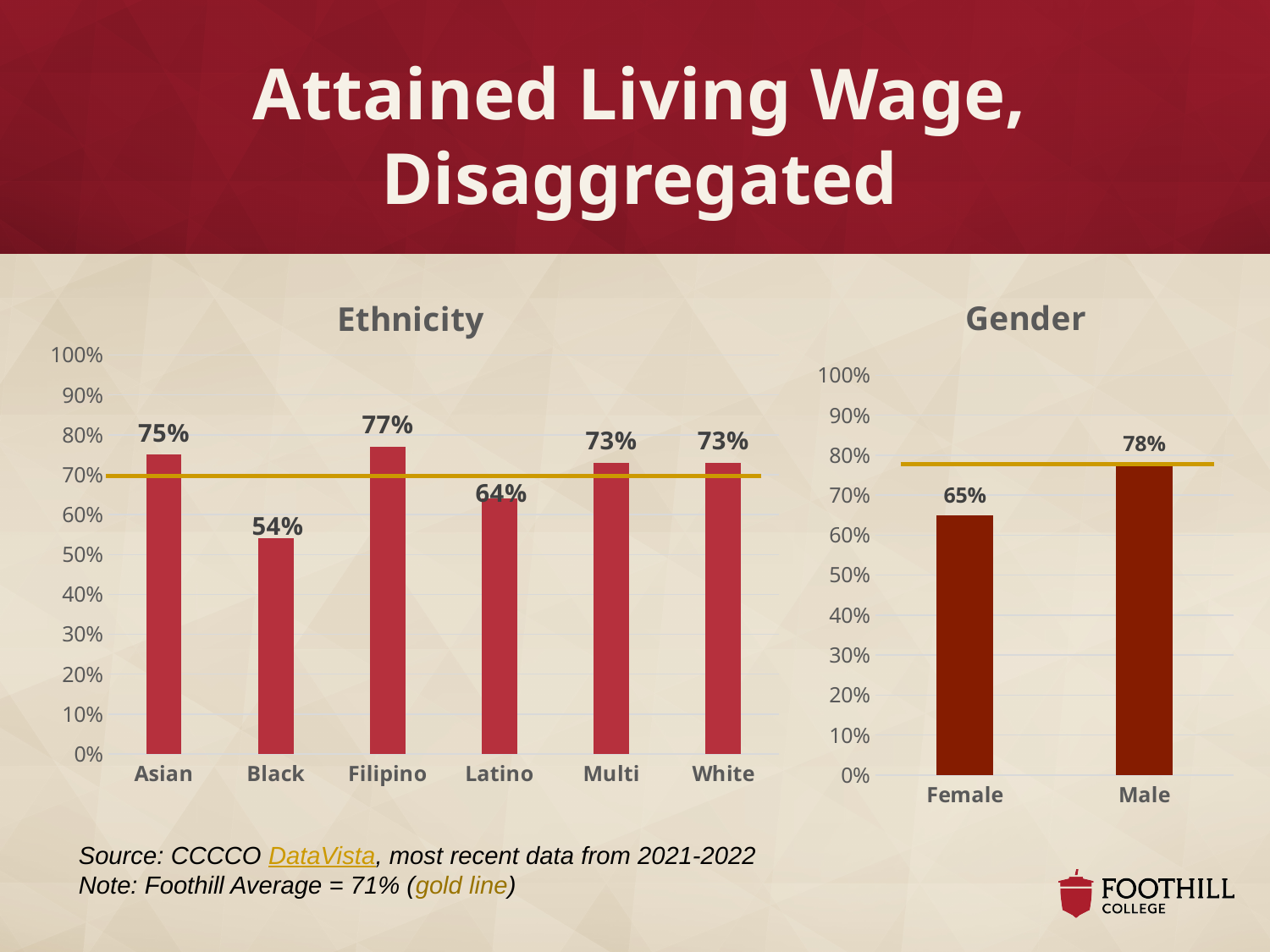
According to the note on the slide, what value does the gold line represent? Foothill Average = 71% In the Ethnicity chart, what is the difference between the values for Asian and Latino? 11% How many categories are shown in the Ethnicity chart? 6 In the Ethnicity chart, which category has the highest value? Filipino In the Ethnicity chart, what is the value for Black? 54% What kind of chart is the Gender chart? Bar chart In the Gender chart, what is the value for Male? 78% In the Ethnicity chart, what is the value for Filipino? 77% In the Ethnicity chart, which category has the lowest value? Black In the Gender chart, what is the value for Female? 65% In the Gender chart, what is the difference between the values for Male and Female? 13% In the Ethnicity chart, which is larger, the value for Asian or the value for Latino? Asian